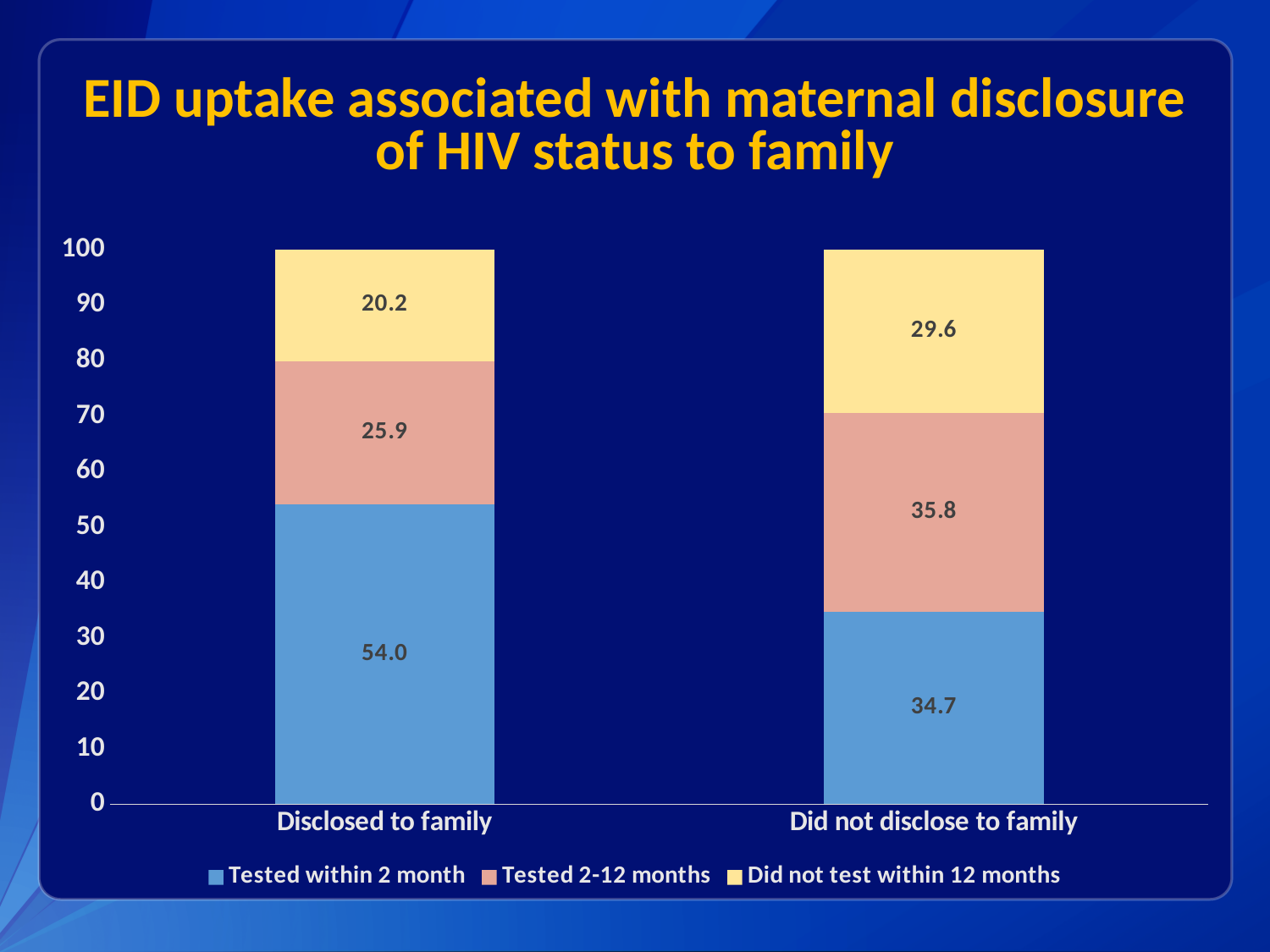
Which segment is the largest in the 'Disclosed to family' bar? Tested within 2 month What is the difference between the 'Tested within 2 month' values for 'Disclosed to family' and 'Did not disclose to family'? 19.3 Which category has the higher value for 'Tested within 2 month'? Disclosed to family What is the value for 'Tested within 2 month' in the 'Disclosed to family' bar? 54.0 Which segment is the smallest in the 'Did not disclose to family' bar? Did not test within 12 months What is the value for 'Did not test within 12 months' in the 'Did not disclose to family' bar? 29.6 What is the value for 'Did not test within 12 months' in the 'Disclosed to family' bar? 20.2 How many series does the legend list? 3 What is the value for 'Tested 2-12 months' in the 'Did not disclose to family' bar? 35.8 What kind of chart is shown on the slide? Stacked bar chart How many categories are shown on the x axis? 2 What is the difference between the 'Did not test within 12 months' values for 'Did not disclose to family' and 'Disclosed to family'? 9.4